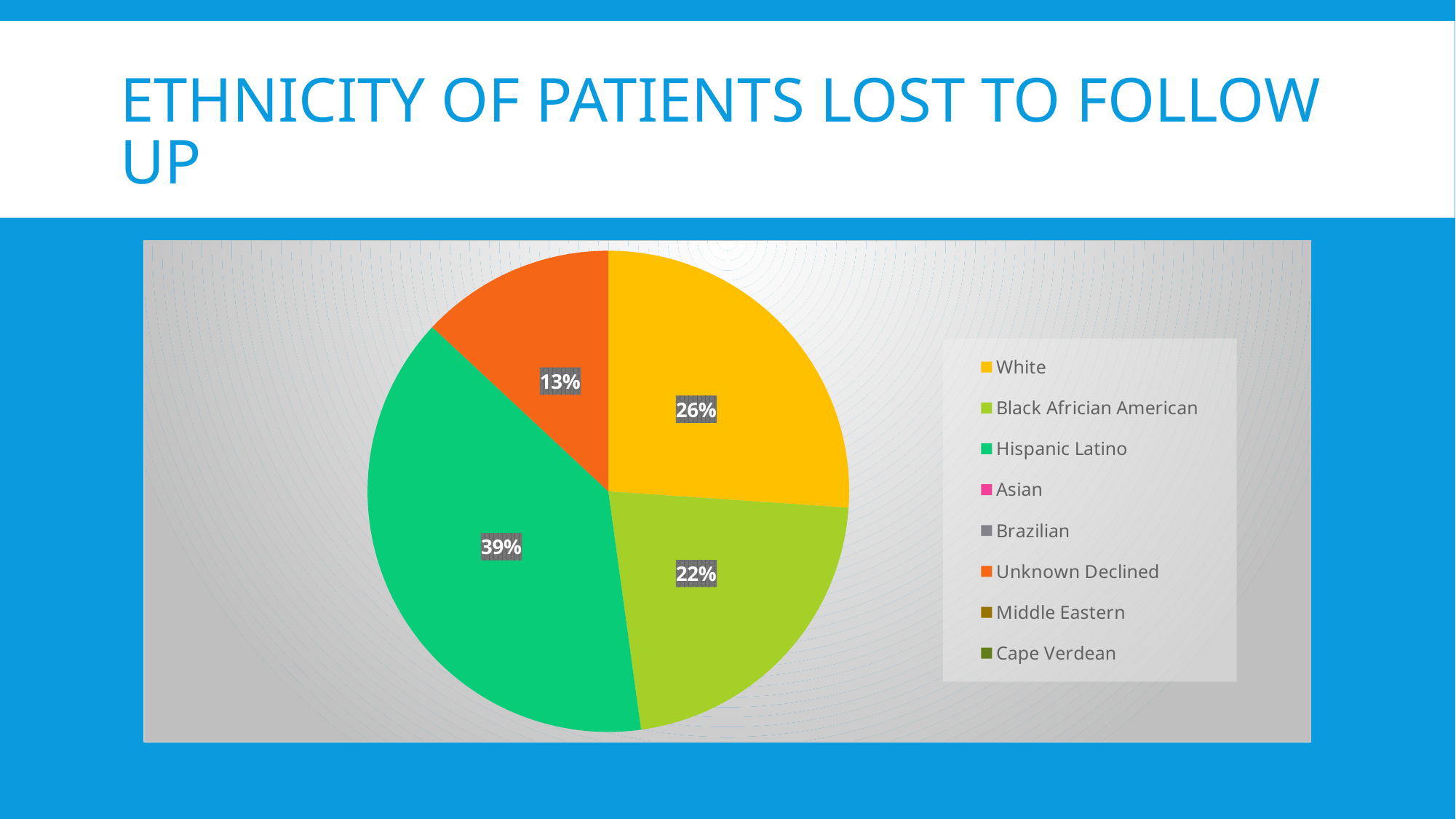
What share of the pie is Unknown Declined? 13% What is the difference in percentage points between the Hispanic Latino and White slices? 13 How many entries does the legend list? 8 Which ethnicity has the largest slice of the pie? Hispanic Latino Which slice is larger, White or Black African American? White Of the slices with a printed label, which has the smallest share? Unknown Declined What share of the pie is Black African American? 22% What share of the pie is Hispanic Latino? 39% What kind of chart is shown on the slide? Pie chart What colour is the Hispanic Latino slice? Green What is the title of the slide containing the chart? Ethnicity of Patients Lost to Follow Up